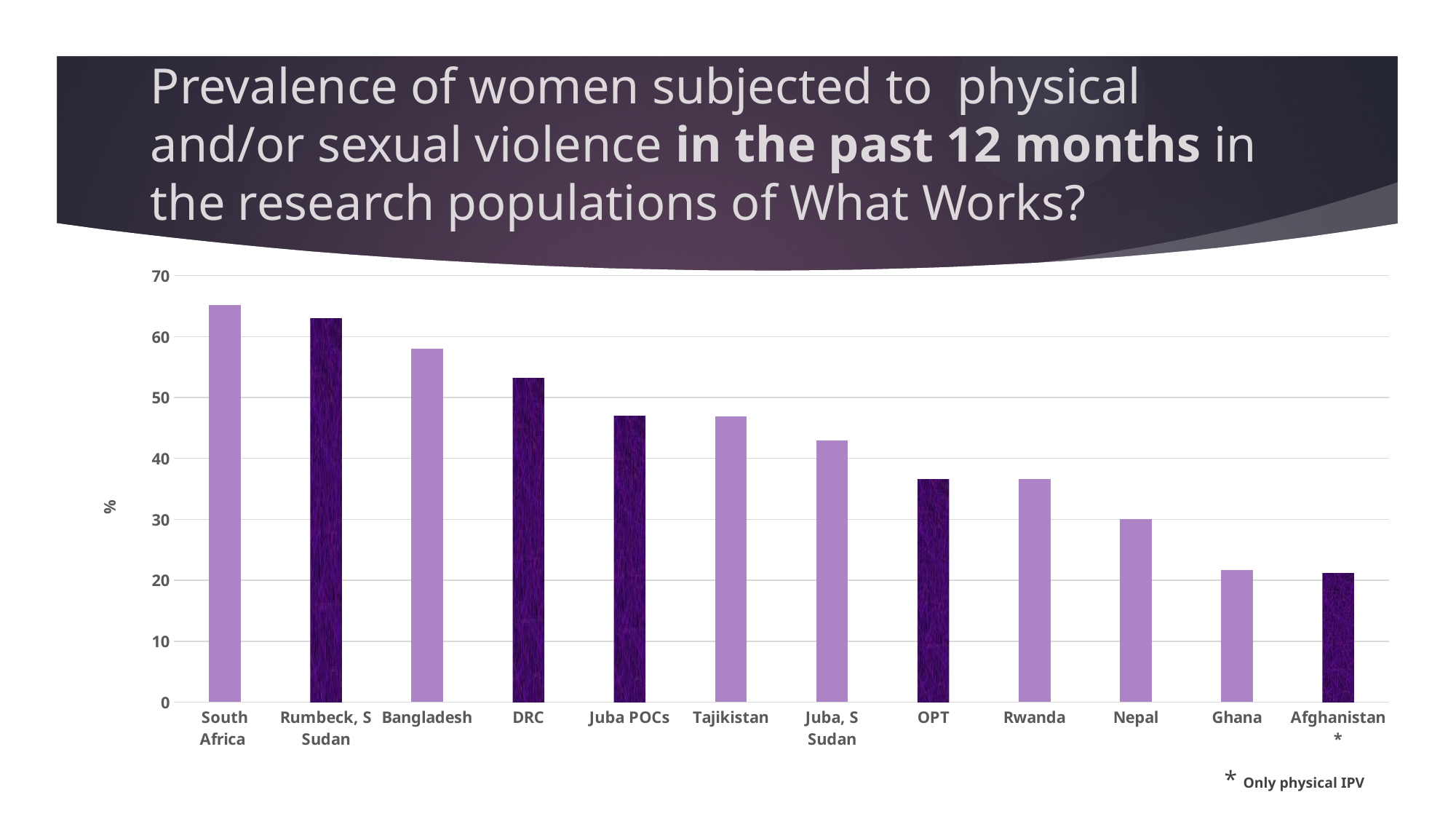
Is the value for OPT greater or less than 40? less Is the value for Ghana greater or less than 20? greater How many research populations (categories) are plotted on the chart? 12 What kind of chart is shown on the slide? bar chart Which has the larger value, Nepal or Ghana? Nepal Is the value for South Africa greater or less than 60? greater Which research population has the highest prevalence on the chart? South Africa Do the bar values rise or fall moving from left to right along the x axis? fall What does the asterisk next to Afghanistan indicate, according to the footnote? Only physical IPV Which has the larger value, Bangladesh or DRC? Bangladesh